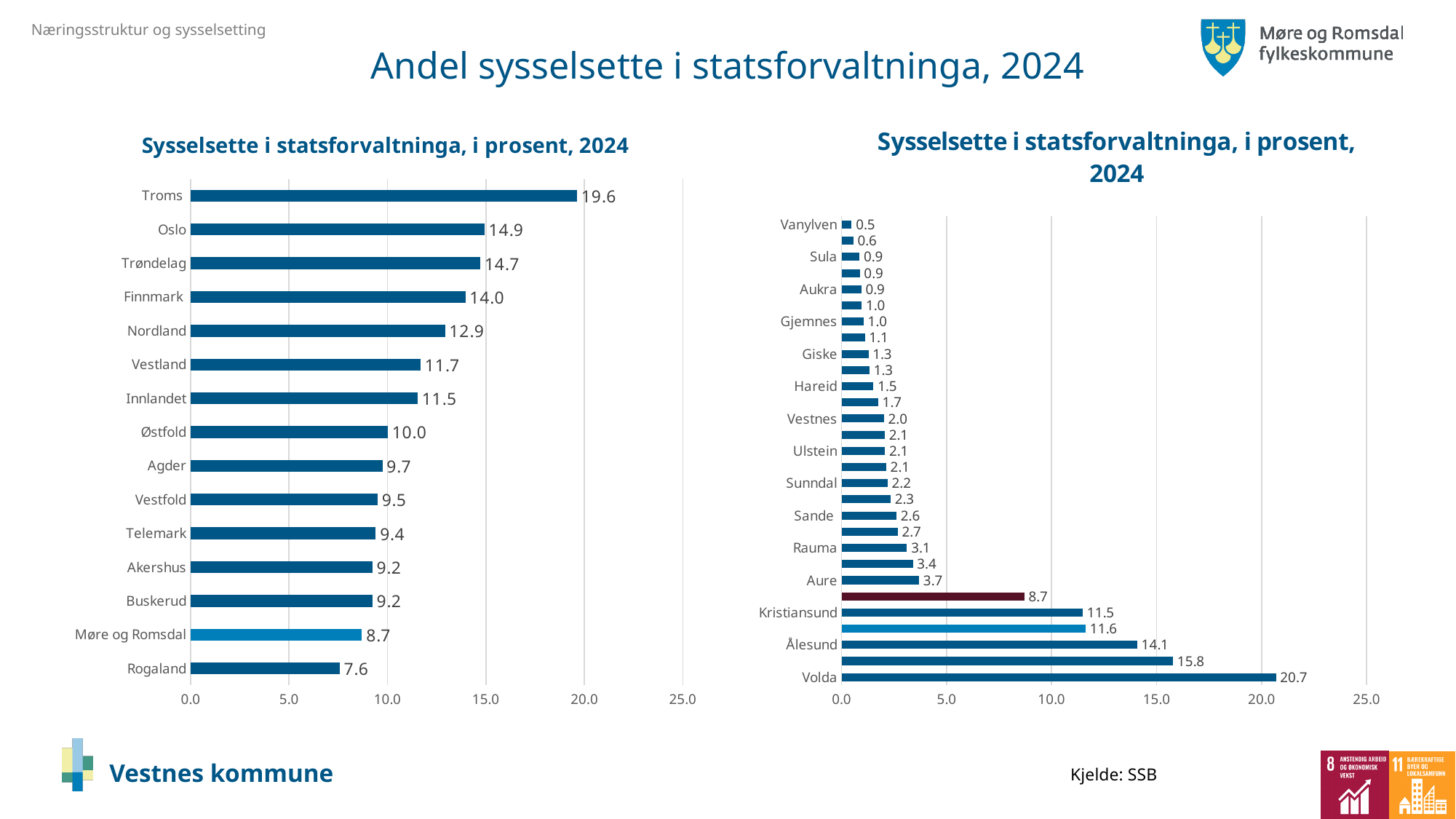
On the right chart, what is the value for Vestnes? 2.0 What kind of chart is the left chart? Bar chart On the right chart, which bar is coloured dark red? The bar with value 8.7 On the right chart, which labelled category has the highest value? Volda On the left chart, what is the value for Møre og Romsdal? 8.7 On the right chart, what is the difference between the values for Ålesund and Kristiansund? 2.6 On the left chart, what is the difference between the values for Oslo and Rogaland? 7.3 On the left chart, which category has the lowest value? Rogaland On the left chart, which is larger, the value for Nordland or the value for Vestland? Nordland How many categories are shown on the left chart? 15 On the left chart, what is the value for Troms? 19.6 On the right chart, what is the value for Volda? 20.7